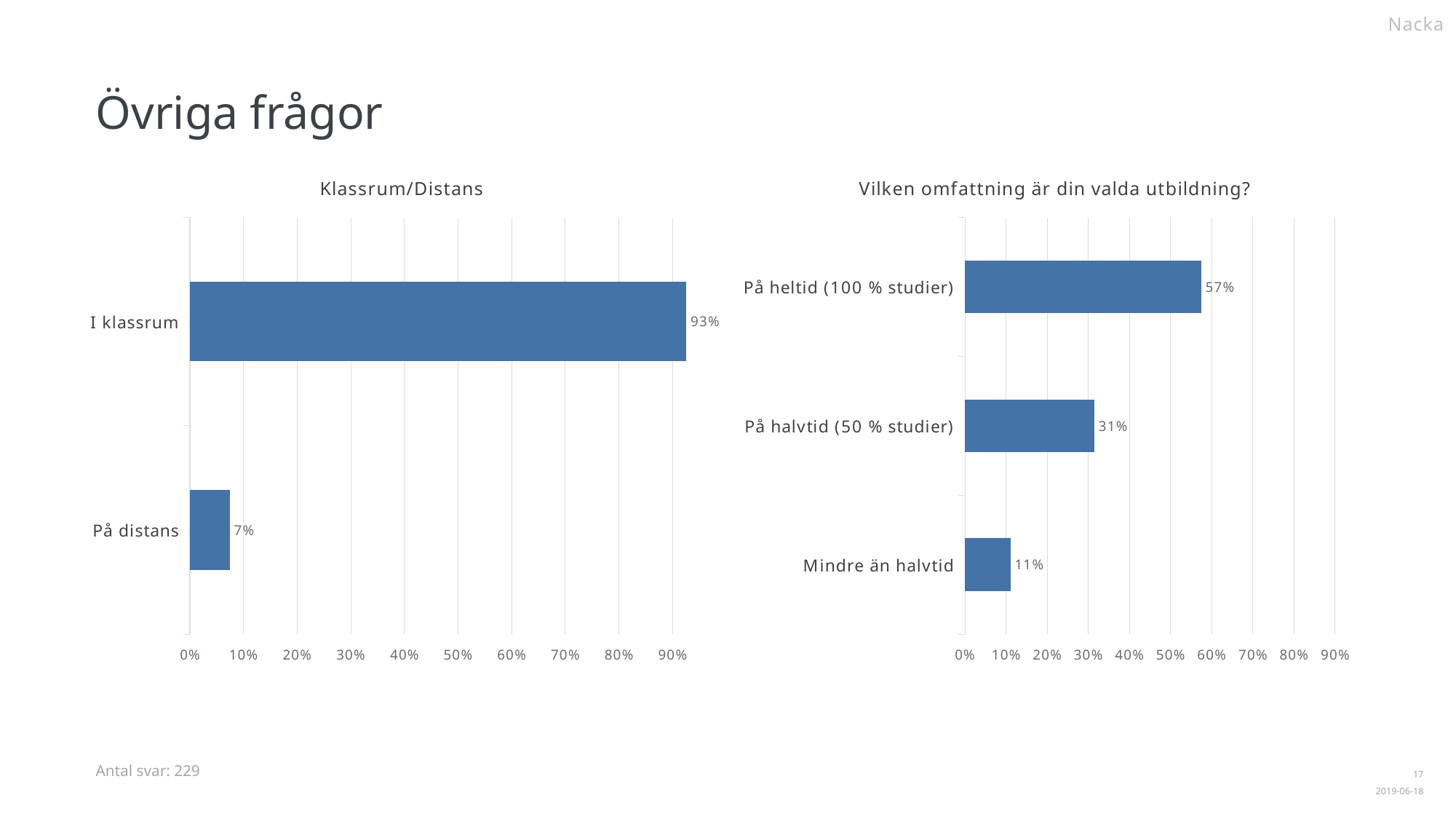
In the 'Klassrum/Distans' chart, what is the value for 'I klassrum'? 93% In the 'Vilken omfattning är din valda utbildning?' chart, what is the difference between 'På heltid (100 % studier)' and 'På halvtid (50 % studier)'? 26% In the 'Vilken omfattning är din valda utbildning?' chart, what is the value for 'Mindre än halvtid'? 11% In the 'Vilken omfattning är din valda utbildning?' chart, which category has the lowest value? Mindre än halvtid In the 'Vilken omfattning är din valda utbildning?' chart, how many categories are shown? 3 In the 'Klassrum/Distans' chart, what is the difference between 'I klassrum' and 'På distans'? 86% What kind of chart is the 'Klassrum/Distans' chart? Bar chart In the 'Vilken omfattning är din valda utbildning?' chart, what is the value for 'På heltid (100 % studier)'? 57% In the 'Vilken omfattning är din valda utbildning?' chart, what is the value for 'På halvtid (50 % studier)'? 31% In the 'Klassrum/Distans' chart, how many categories are shown? 2 In the 'Vilken omfattning är din valda utbildning?' chart, which category has the highest value? På heltid (100 % studier) In the 'Klassrum/Distans' chart, what is the value for 'På distans'? 7%